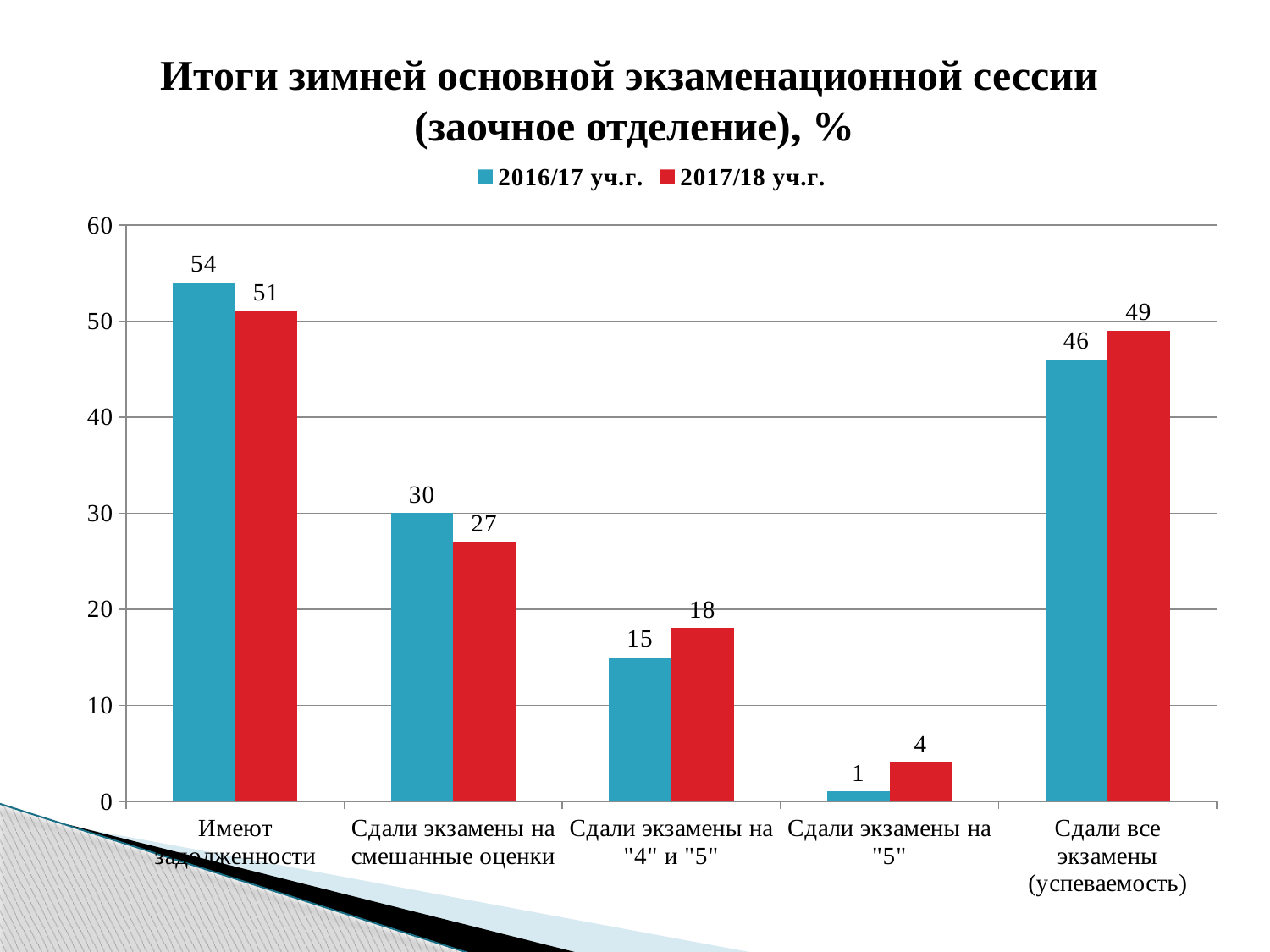
Which category has the highest value in the 2017/18 уч.г. series? Имеют задолженности Which colour represents the 2017/18 уч.г. series? red Which category has the lowest value in the 2016/17 уч.г. series? Сдали экзамены на "5" What is the difference between the 2016/17 уч.г. and 2017/18 уч.г. values for "Сдали экзамены на смешанные оценки"? 3 What is the value for "Сдали все экзамены (успеваемость)" in the 2017/18 уч.г. series? 49 How many series does the legend list? 2 How many categories are shown on the x axis? 5 For "Сдали экзамены на "4" и "5"", which series has the larger value, 2016/17 уч.г. or 2017/18 уч.г.? 2017/18 уч.г. Is the 2017/18 уч.г. value for "Имеют задолженности" greater or less than 40? greater What is the value for "Имеют задолженности" in the 2016/17 уч.г. series? 54 What is the value for "Сдали экзамены на "5"" in the 2016/17 уч.г. series? 1 What kind of chart is shown on the slide? bar chart